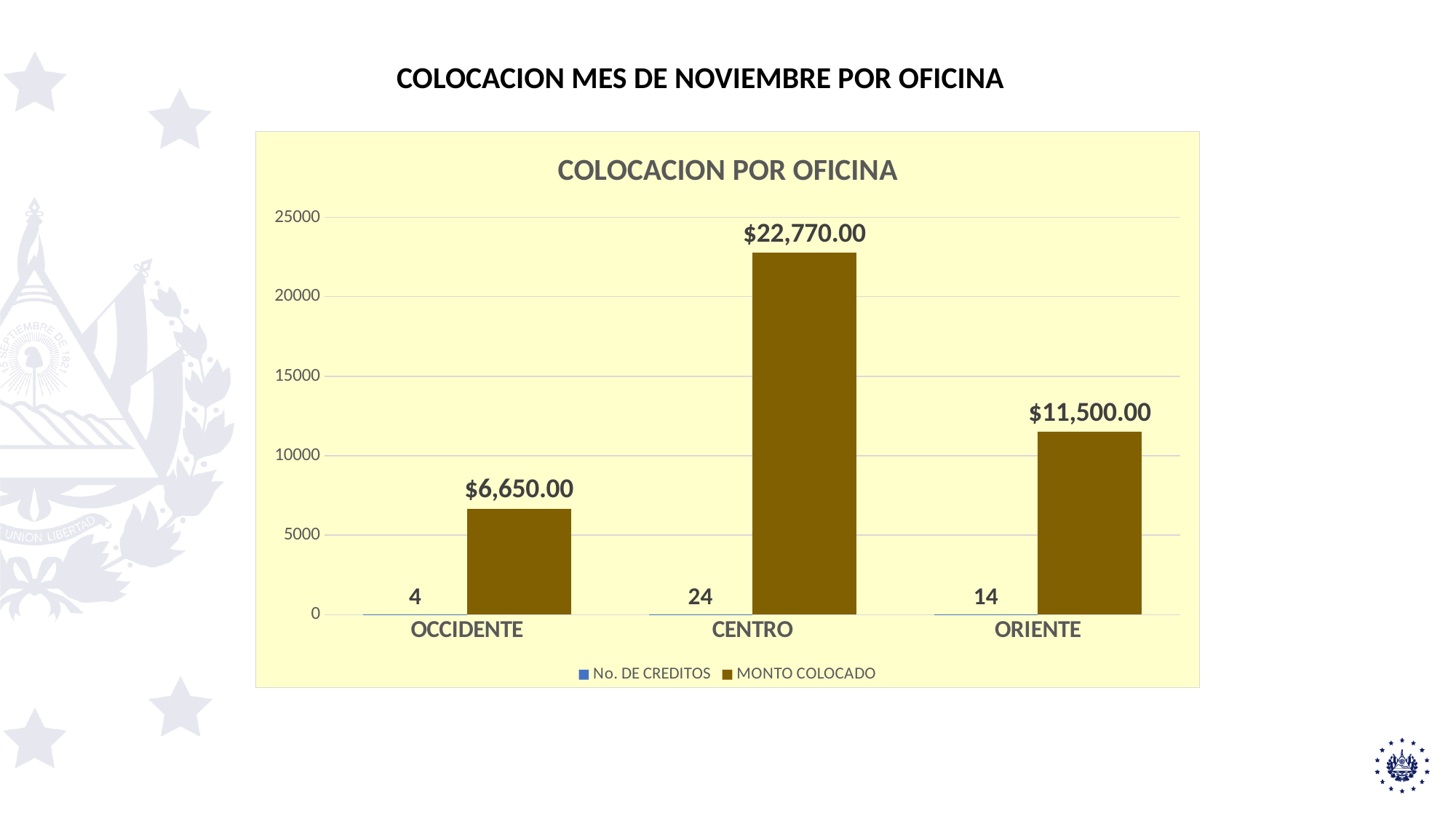
Which office has the lowest No. DE CREDITOS? OCCIDENTE How many offices are shown on the x axis? 3 What is the MONTO COLOCADO value for CENTRO? $22,770.00 What is the MONTO COLOCADO value for OCCIDENTE? $6,650.00 How many series does the legend list? 2 Which office has the highest MONTO COLOCADO? CENTRO Is the MONTO COLOCADO for ORIENTE greater or less than 10000? greater What is the difference in No. DE CREDITOS between CENTRO and OCCIDENTE? 20 What is the difference in MONTO COLOCADO between CENTRO and ORIENTE? $11,270.00 What kind of chart is shown on the slide? bar chart What is the No. DE CREDITOS value for ORIENTE? 14 Which office has a larger MONTO COLOCADO, ORIENTE or OCCIDENTE? ORIENTE